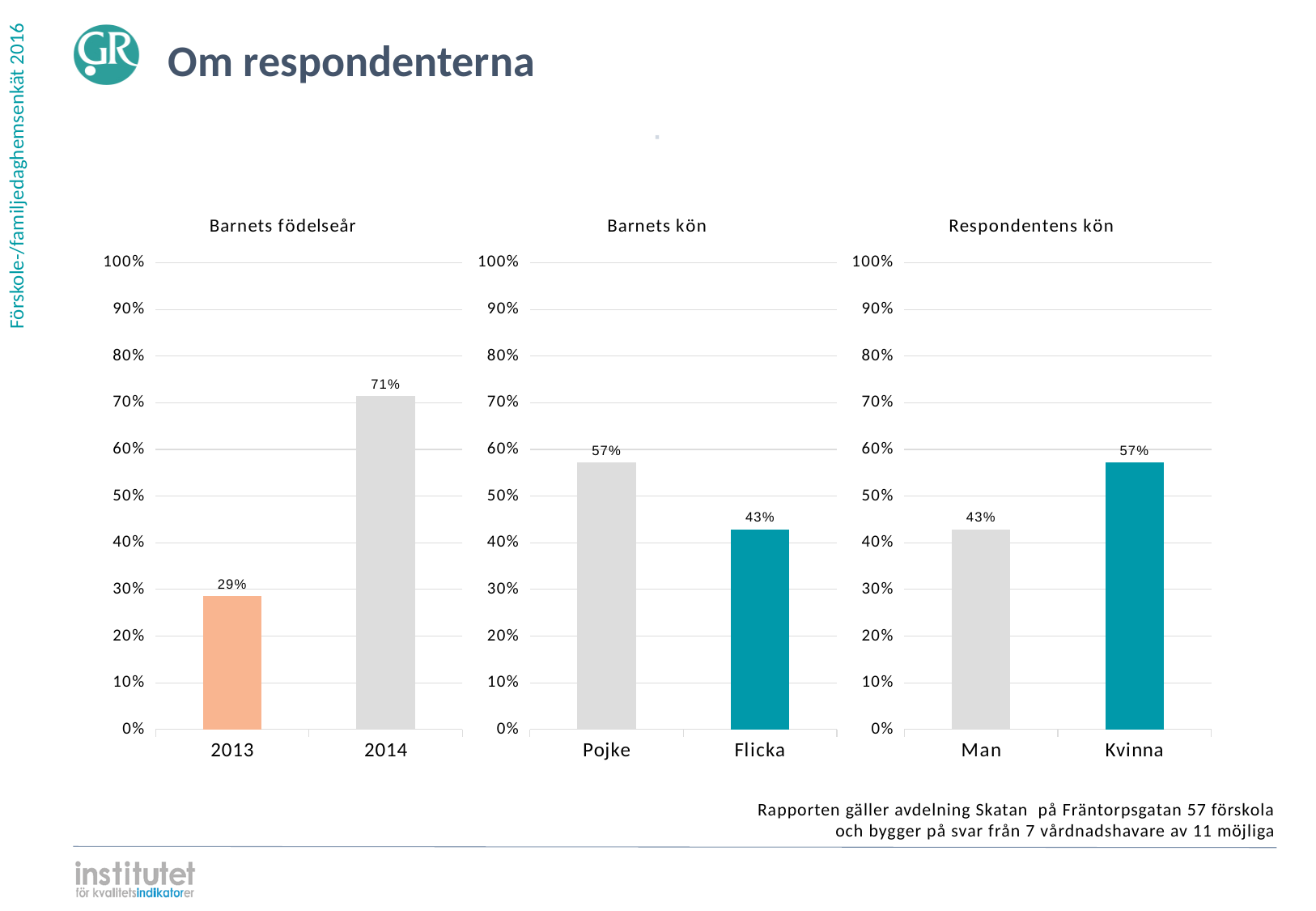
In the 'Barnets kön' chart, is the value for Pojke greater or less than 50%? greater In the 'Respondentens kön' chart, what is the difference between Kvinna and Man? 14% In the 'Barnets kön' chart, which category has the lowest value? Flicka In the 'Barnets kön' chart, what is the value for Pojke? 57% In the 'Barnets födelseår' chart, what is the value for 2014? 71% In the 'Barnets födelseår' chart, which category has the highest value? 2014 What kind of chart is the 'Respondentens kön' chart? bar chart How many categories are shown in the 'Barnets kön' chart? 2 In the 'Respondentens kön' chart, which is larger, Man or Kvinna? Kvinna In the 'Respondentens kön' chart, what is the value for Man? 43% In the 'Barnets födelseår' chart, what is the value for 2013? 29% In the 'Barnets födelseår' chart, what is the difference between 2014 and 2013? 42%